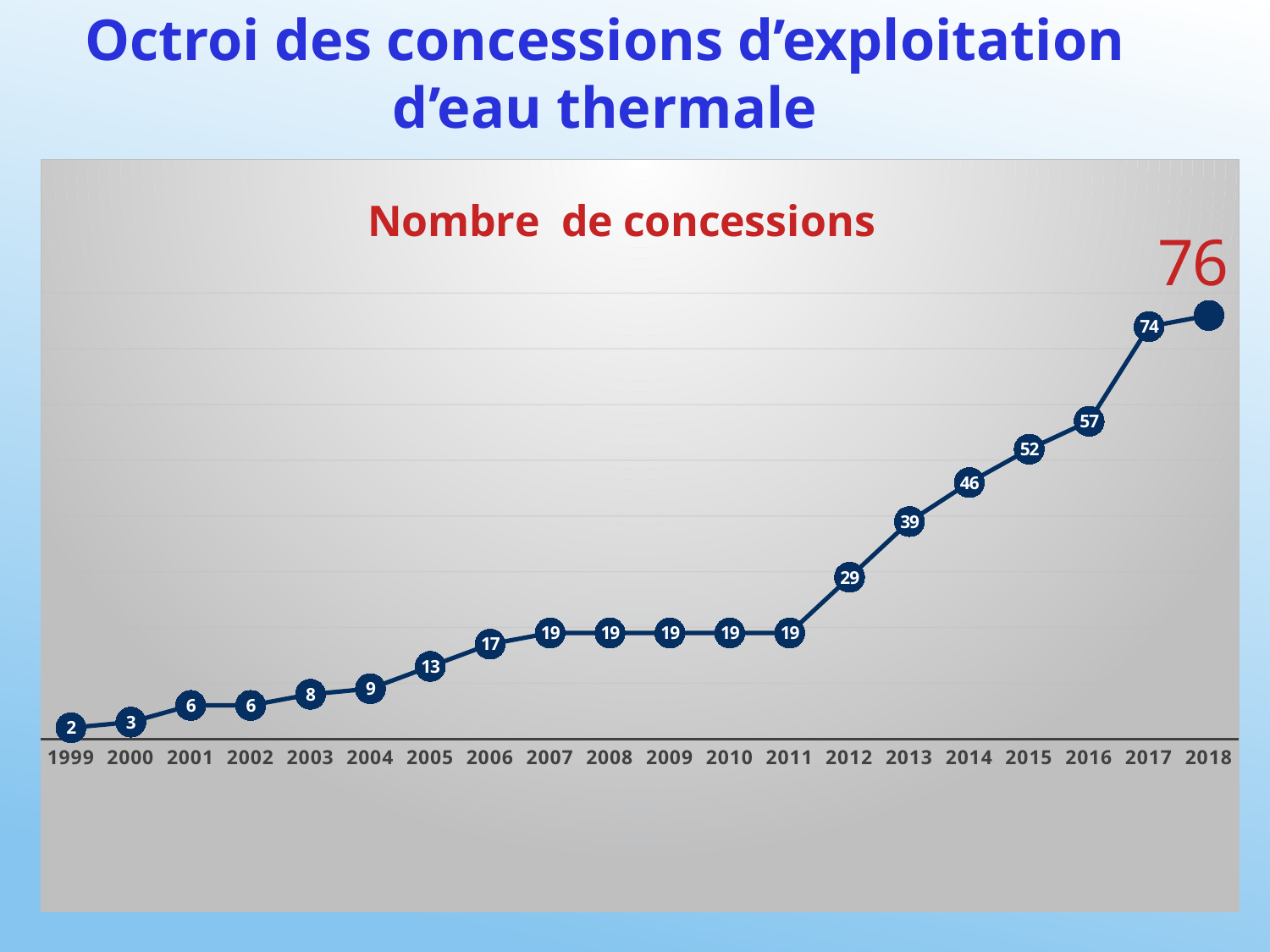
Which year has the highest number of concessions? 2018 What is the difference in the number of concessions between 2012 and 2011? 10 What is the number of concessions in 2005? 13 Which year has the lowest number of concessions? 1999 What kind of chart is shown on the slide? Line chart What is the number of concessions in 2018? 76 Do the values rise or fall from 1999 to 2018? Rise What is the difference in the number of concessions between 2017 and 2016? 17 How many years are shown on the x axis? 20 Which year has more concessions, 2014 or 2015? 2015 What is the title of the chart? Nombre de concessions What is the number of concessions in 2013? 39